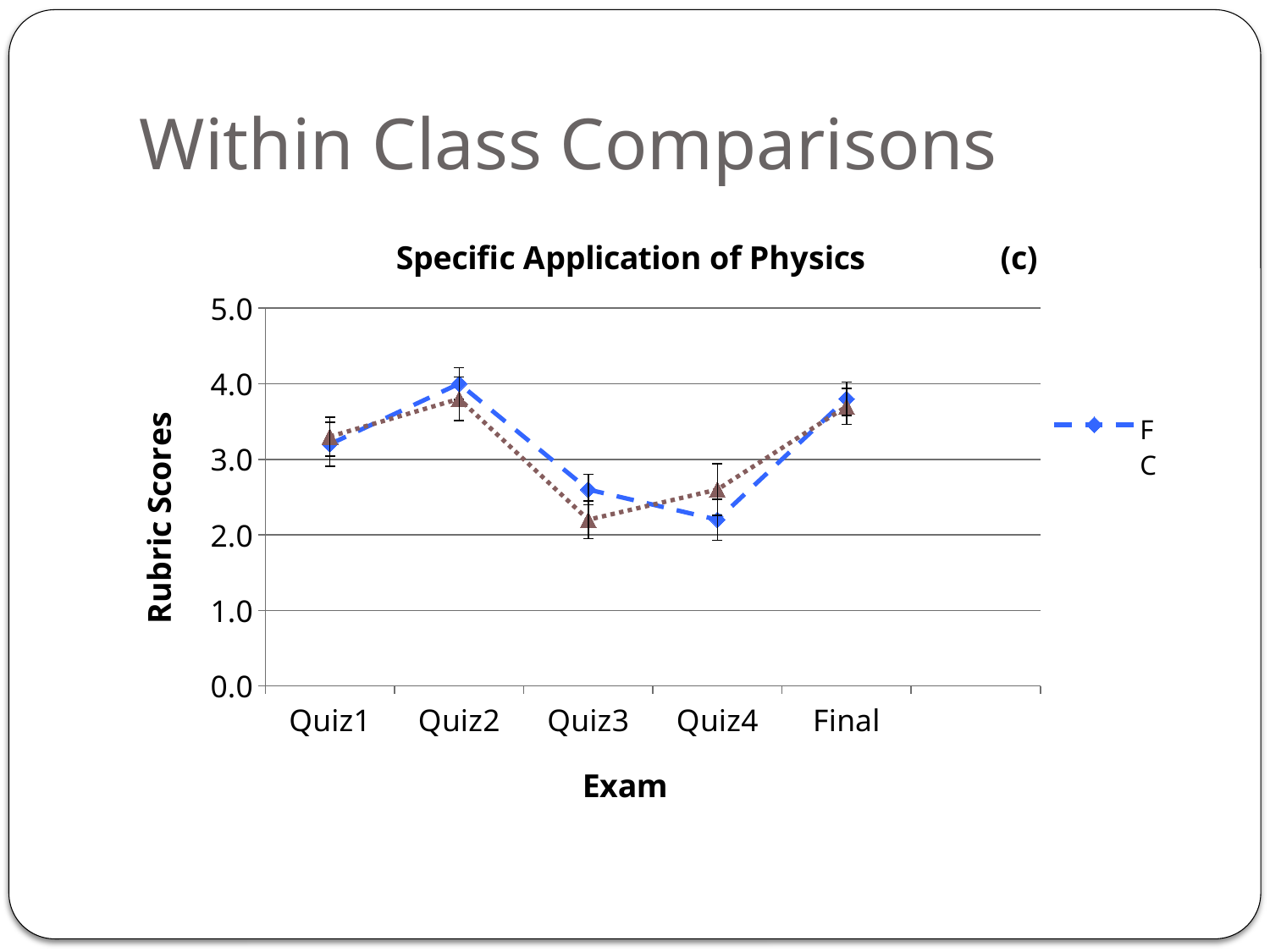
What is the label of the y axis? Rubric Scores Do the rubric scores for series F rise or fall from Quiz2 to Quiz4? fall For which exam does series F have its lowest rubric score? Quiz4 For which exam does series F reach its highest rubric score? Quiz2 What is the title of the chart? Specific Application of Physics For which exam does series C have its lowest rubric score? Quiz3 How many exam categories are shown on the x axis? 5 At Quiz4, which series has the higher rubric score, F or C? C At Quiz3, which series has the higher rubric score, F or C? F How many series does the legend list? 2 What kind of chart is shown on the slide? line chart Is the value for series F at Quiz4 greater or less than 3.0? less